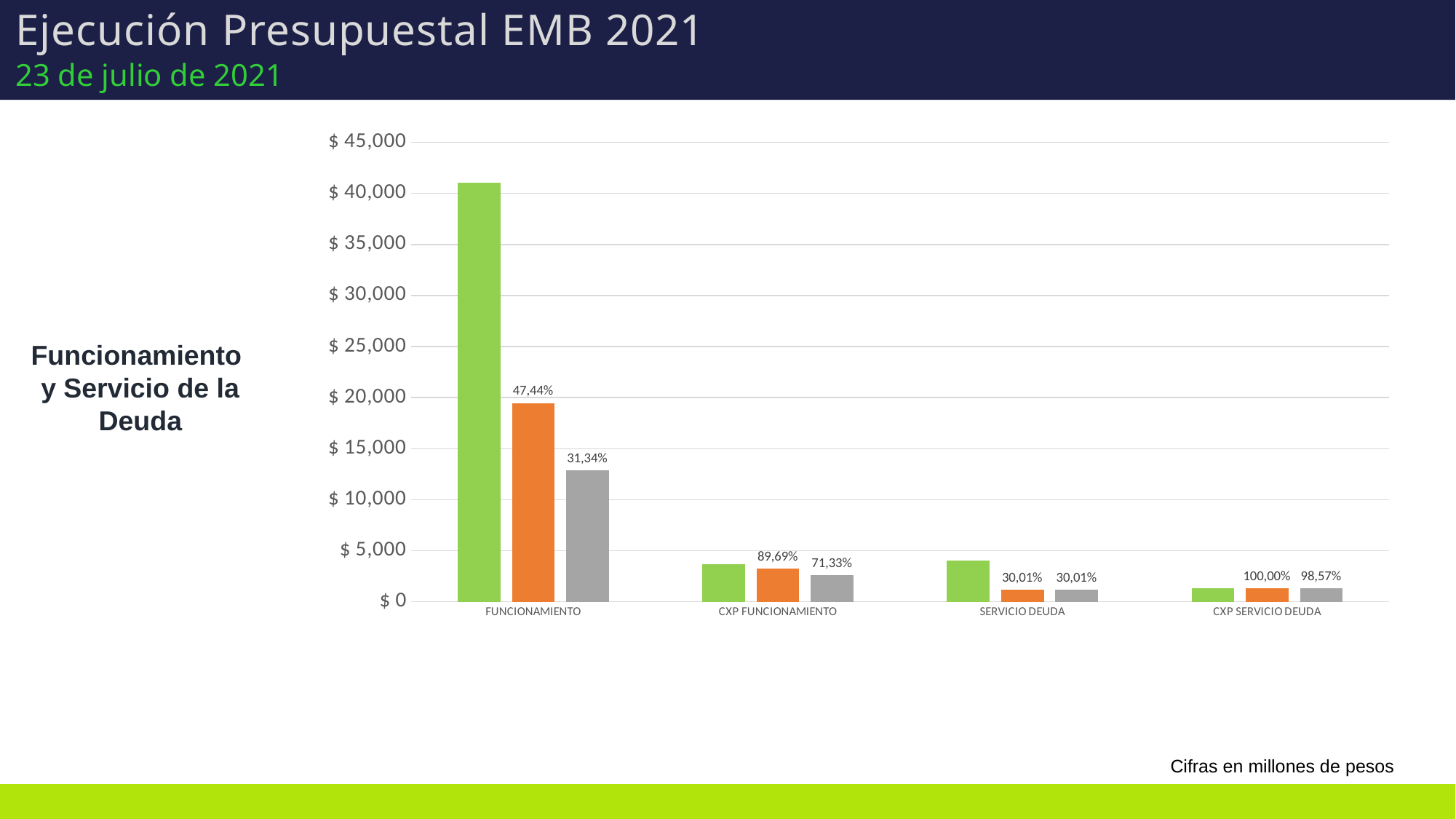
What percentage label is shown on the orange bar for FUNCIONAMIENTO? 47,44% Is the value of the green bar for FUNCIONAMIENTO greater or less than $ 35,000? greater What kind of chart is shown on the slide? bar chart For FUNCIONAMIENTO, which bar is taller, the orange bar or the gray bar? the orange bar What percentage label is shown on the orange bar for CXP SERVICIO DEUDA? 100,00% Which category has the shortest green bar? CXP SERVICIO DEUDA How many categories are shown on the x axis of the chart? 4 What is the difference between the orange bar label and the gray bar label for FUNCIONAMIENTO? 16,10% What percentage label is shown on the gray bar for CXP FUNCIONAMIENTO? 71,33% What percentage label is shown on the gray bar for SERVICIO DEUDA? 30,01% Which category has the tallest green bar? FUNCIONAMIENTO Is the value of the green bar for CXP FUNCIONAMIENTO greater or less than $ 5,000? less